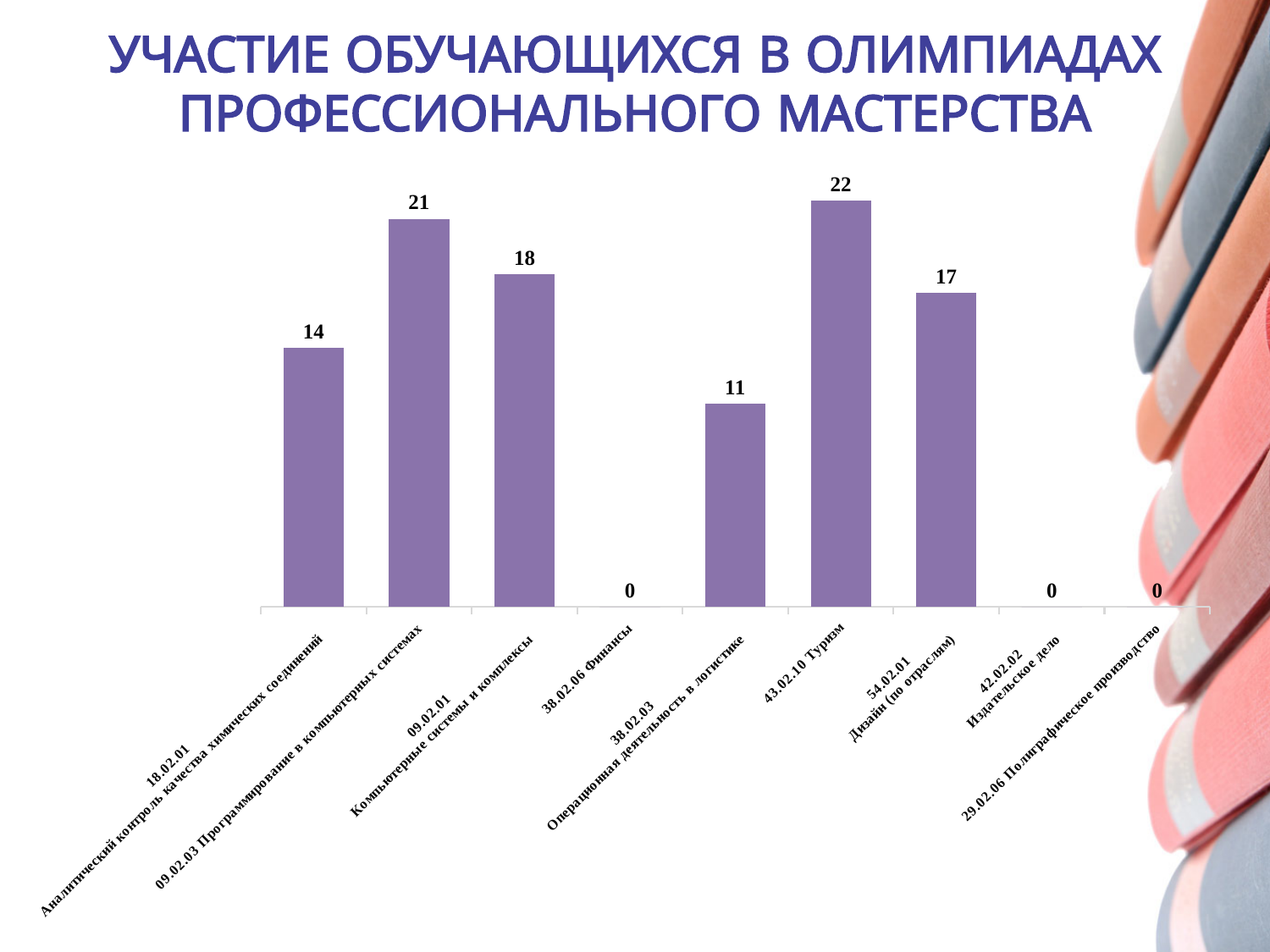
What is the difference between the values for 43.02.10 Туризм and 18.02.01 Аналитический контроль качества химических соединений? 8 What kind of chart is shown on the slide? Bar chart What is the value for 43.02.10 Туризм? 22 Which category has the highest value? 43.02.10 Туризм What is the value for 54.02.01 Дизайн (по отраслям)? 17 What is the value for 38.02.03 Операционная деятельность в логистике? 11 How many categories are shown on the x axis? 9 Which category has the lowest non-zero value? 38.02.03 Операционная деятельность в логистике What is the title of the slide? УЧАСТИЕ ОБУЧАЮЩИХСЯ В ОЛИМПИАДАХ ПРОФЕССИОНАЛЬНОГО МАСТЕРСТВА How many categories have a value of 0? 3 Which is larger, the value for 09.02.01 Компьютерные системы и комплексы or the value for 54.02.01 Дизайн (по отраслям)? 09.02.01 Компьютерные системы и комплексы What is the value for 09.02.03 Программирование в компьютерных системах? 21